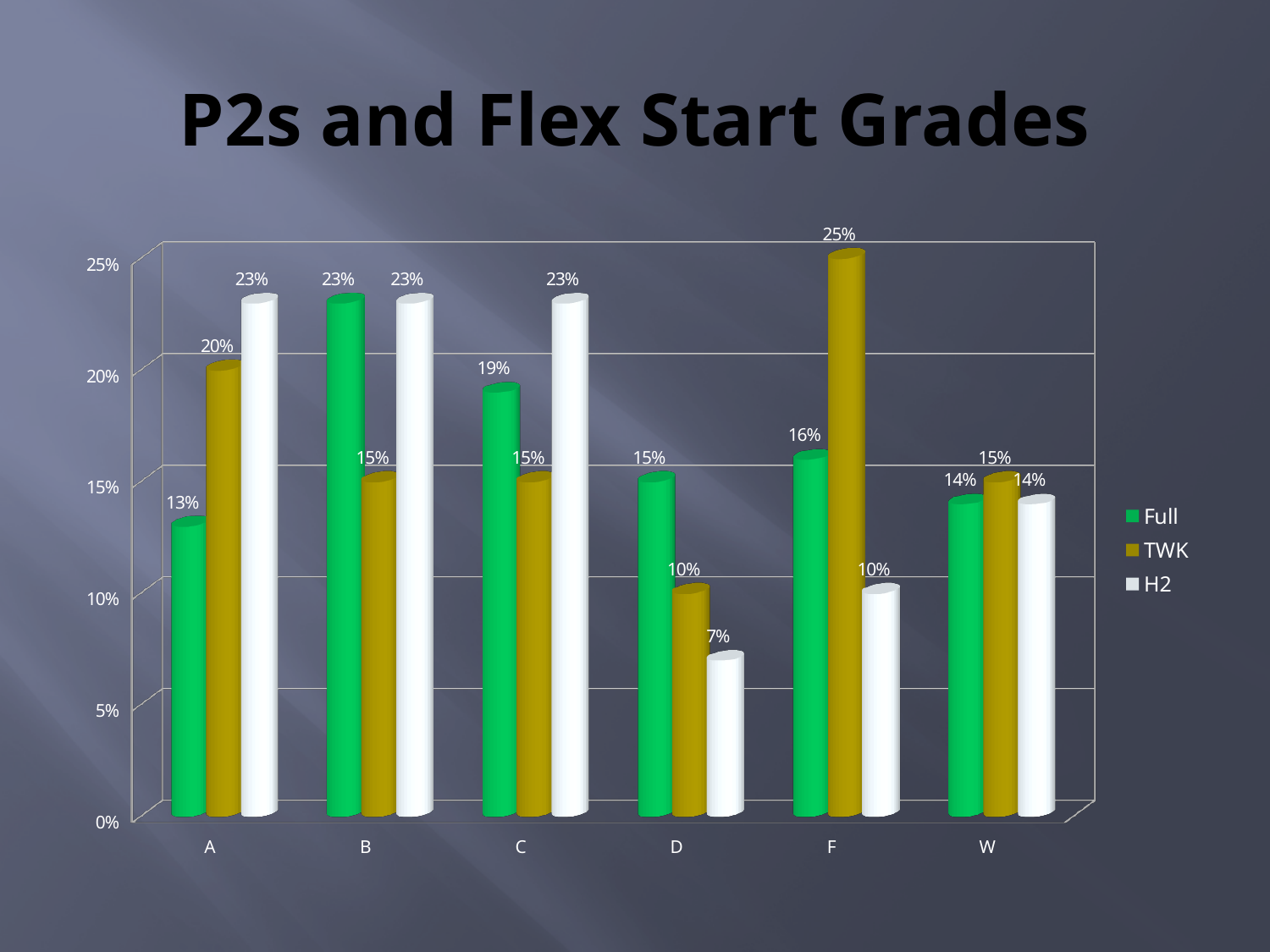
What is the difference between the TWK and H2 values in category F? 15% What is the title of the chart? P2s and Flex Start Grades What is the value for Full in category C? 19% How many series does the legend list? 3 Which is larger in category A, the Full value or the H2 value? H2 What is the value for H2 in category D? 7% Which category has the lowest Full value? A How many categories are shown on the x axis? 6 What kind of chart is shown on the slide? Bar chart What is the value for TWK in category A? 20% Which series is shown in white? H2 Which category has the highest TWK value? F